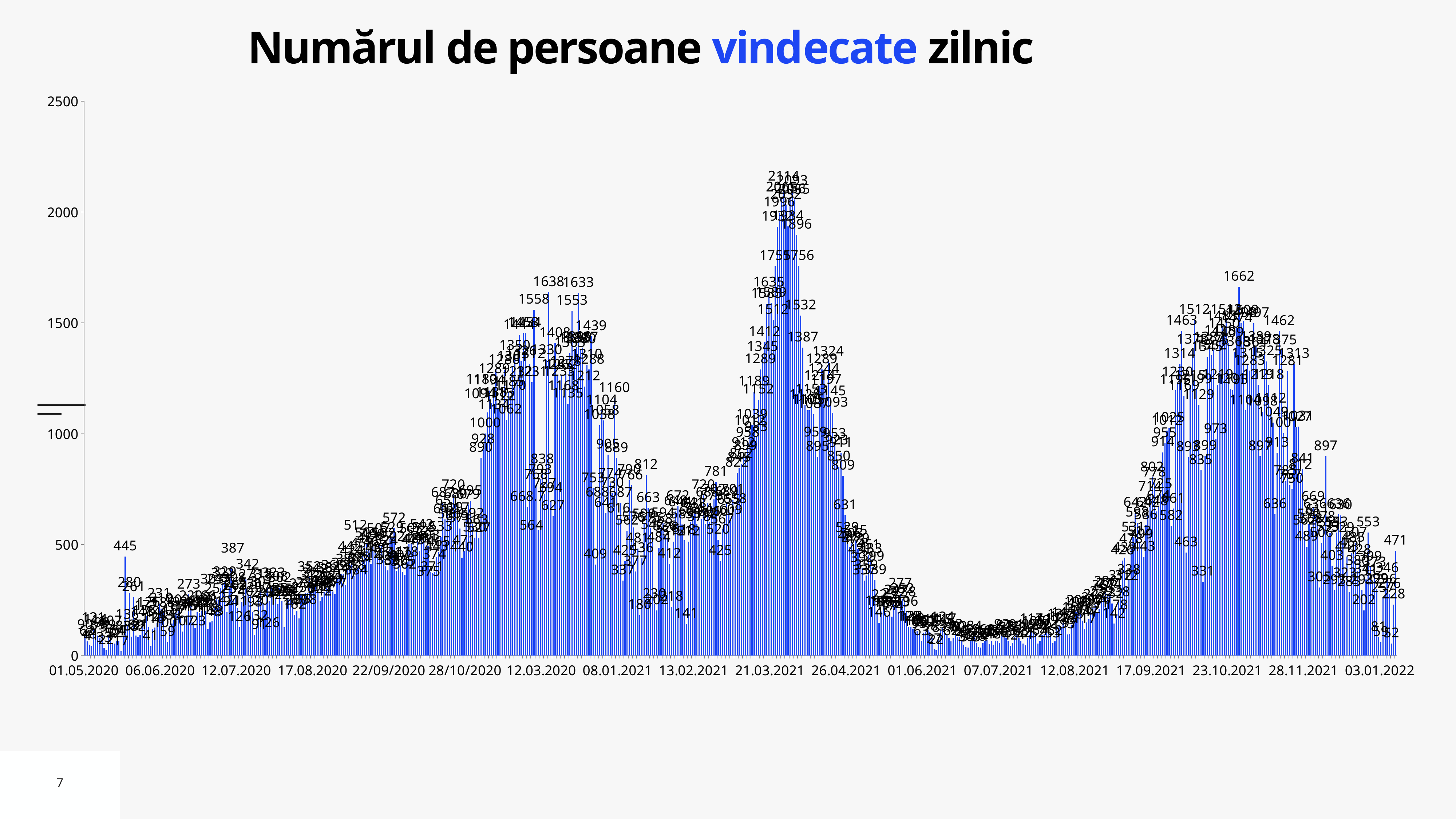
What is the title of the chart? Numărul de persoane vindecate zilnic What is the difference between the highest peak (2114) and the autumn 2021 peak (1662)? 452 Do the values rise or fall along the x axis from 07.07.2021 to 23.10.2021? rise What is the maximum value shown on the vertical axis? 2500 What kind of chart is shown on the slide? bar chart What is the highest daily value labelled on the chart? 2114 What is the value labelled on the last bar at the right end of the chart (03.01.2022)? 471 What is the value of the tallest bar in the autumn 2021 wave (around 23.10.2021)? 1662 Are the daily values around 07.07.2021 greater or less than 500? less Which peak is higher: the one around 21.03.2021 or the one around 23.10.2021? the one around 21.03.2021 Is the highest peak of the chart (around 21.03.2021) greater or less than 2000? greater What is the value of the tallest bar between 01.05.2020 and 06.06.2020? 445